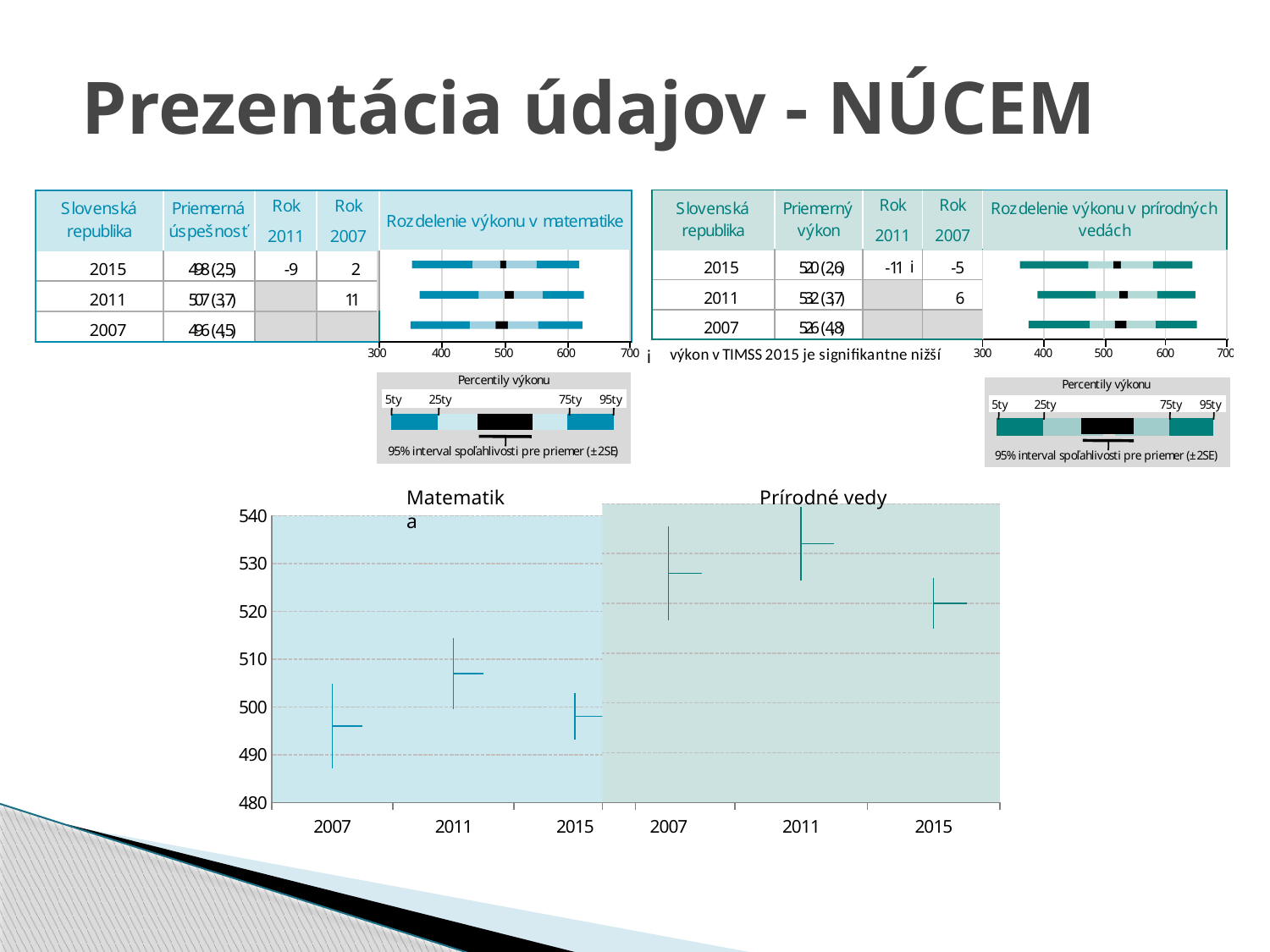
In the right table, what is the value in the Rok 2011 column for 2015? -11 In the left table, what is the Priemerná úspešnosť for 2015? 498 (2,5) In the bottom chart, does the value for Matematika rise or fall from 2011 to 2015? fall What are the two panels of the bottom chart labelled? Matematika and Prírodné vedy In the bottom chart, is the value for Matematika in 2007 greater or less than 500? less In the bottom chart, which year has the lowest value for Prírodné vedy? 2015 In the bottom chart, which is larger for Matematika: the value for 2011 or the value for 2015? 2011 In the bottom chart, is the value for Prírodné vedy in 2015 greater or less than 530? less In the bottom chart, how many years are plotted for each subject? 3 In the bottom chart, which year has the highest value for Matematika? 2011 In the bottom chart, is the value for Matematika in 2011 greater or less than 500? greater